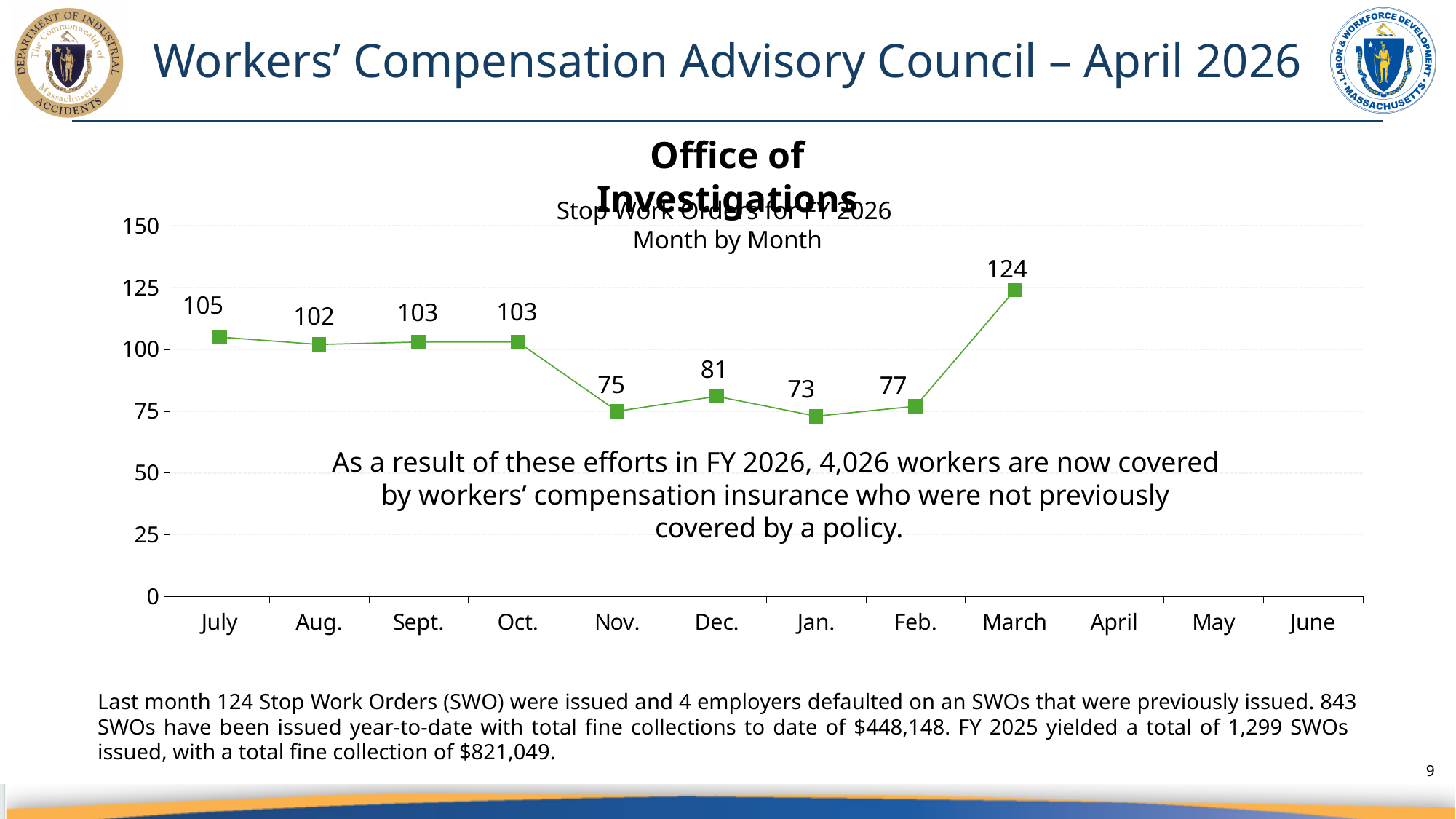
Which month has the highest number of Stop Work Orders? March How many Stop Work Orders were issued in July? 105 What is the title of the chart? Stop Work Orders for FY 2026 Month by Month What is the difference between the July value and the Aug. value? 3 What is the difference between the March value and the Feb. value? 47 How many months have a data point plotted on the chart? 9 What is the value plotted for Nov.? 75 Which is larger, the value for Dec. or the value for Nov.? Dec. What type of chart is shown on the slide? line chart What is the value plotted for Jan.? 73 Do the values rise or fall from Oct. to Nov.? fall Which month has the lowest number of Stop Work Orders? Jan.